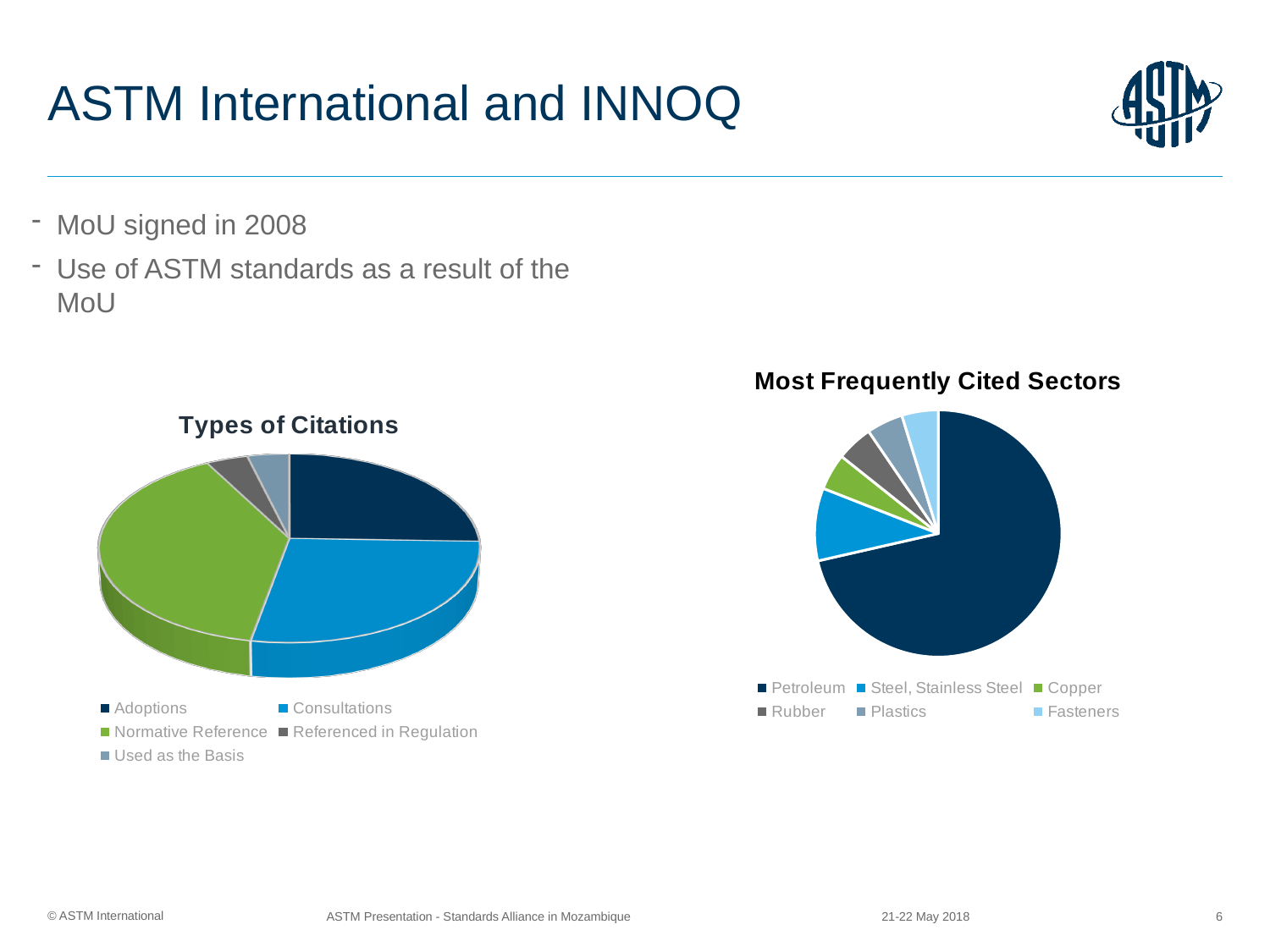
How many slices does the "Most Frequently Cited Sectors" pie chart have? 6 In the "Types of Citations" chart, which slice is larger, Consultations or Referenced in Regulation? Consultations In the "Most Frequently Cited Sectors" chart, which slice is larger, Petroleum or Steel, Stainless Steel? Petroleum In the "Types of Citations" chart, which category is shown in green? Normative Reference What is the title of the pie chart on the right side of the slide? Most Frequently Cited Sectors How many slices does the "Types of Citations" pie chart have? 5 In the "Types of Citations" chart, which slice is larger, Normative Reference or Adoptions? Normative Reference What kind of chart is the "Most Frequently Cited Sectors" chart? Pie chart What kind of chart is the "Types of Citations" chart? Pie chart In the "Most Frequently Cited Sectors" chart, which sector has the largest slice? Petroleum How many entries does the legend of the "Most Frequently Cited Sectors" chart list? 6